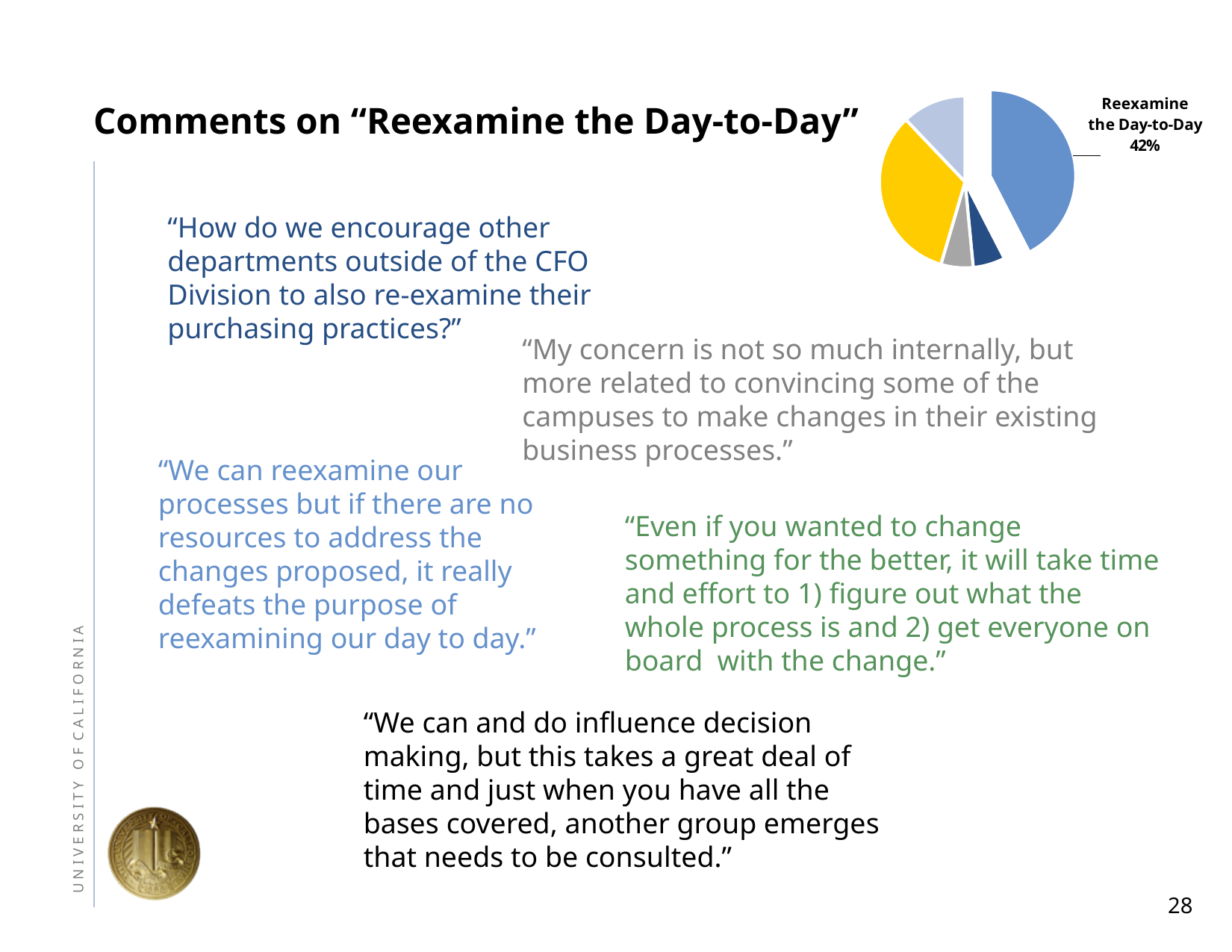
Which slice of the pie chart is pulled out (exploded) from the rest of the pie? Reexamine the Day-to-Day What percentage is shown for the "Reexamine the Day-to-Day" slice of the pie chart? 42% What kind of chart is shown on the slide? Pie chart Which slice of the pie chart is the largest? Reexamine the Day-to-Day What colour is the "Reexamine the Day-to-Day" slice in the pie chart? Blue What share of the pie does the "Reexamine the Day-to-Day" slice represent? 42% How many slices does the pie chart have? 5